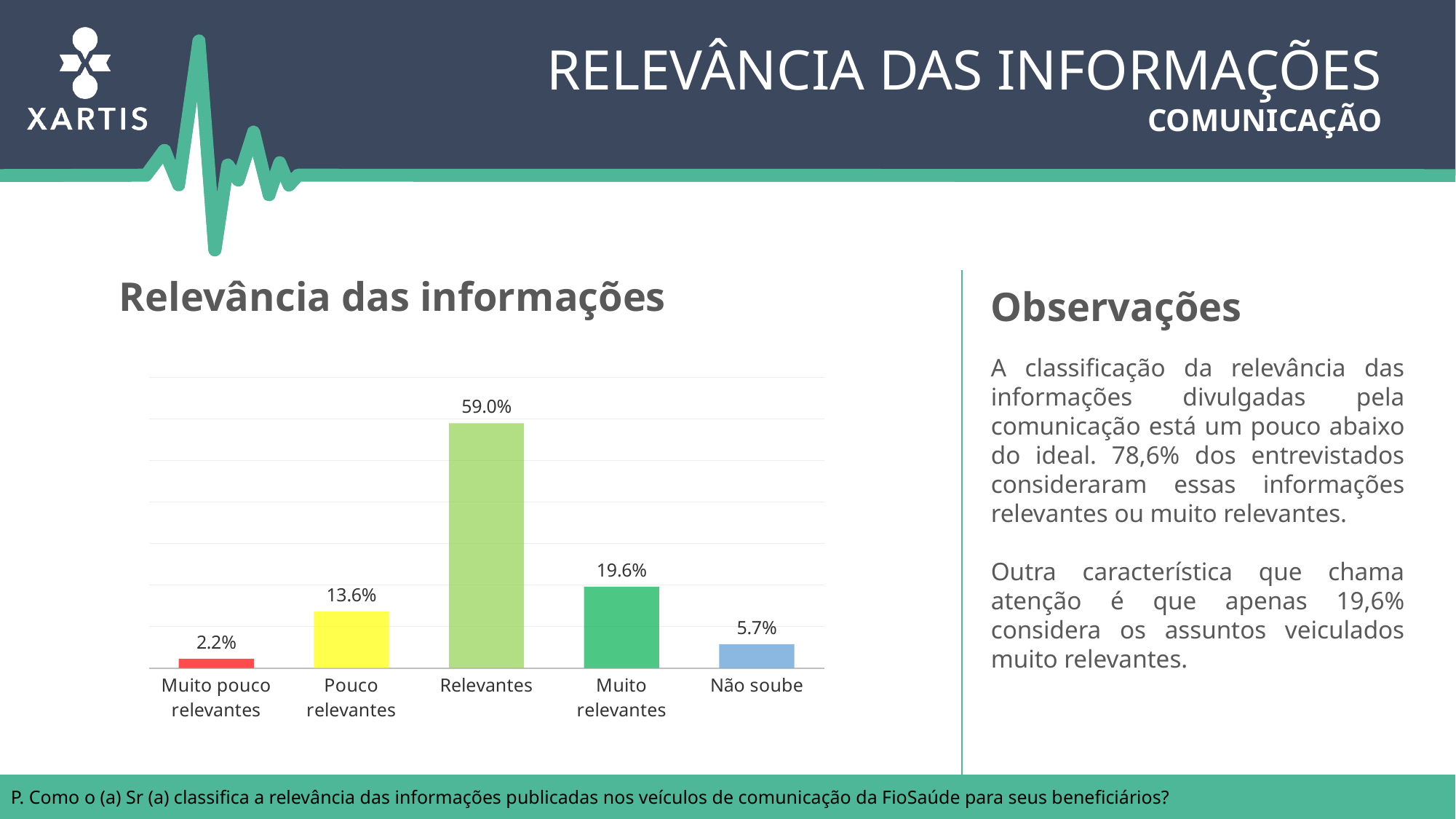
What is the value for Não soube? 5.7% What colour is the bar for Muito pouco relevantes? Red Which category has the lowest value? Muito pouco relevantes What is the value for Relevantes? 59.0% How many categories are shown on the x axis? 5 What is the value for Pouco relevantes? 13.6% Which category has the highest value? Relevantes Which is larger, the value for Pouco relevantes or the value for Não soube? Pouco relevantes What kind of chart is shown on the slide? Bar chart What is the difference between the values for Relevantes and Muito relevantes? 39.4% What is the title of the chart? Relevância das informações What is the value for Muito pouco relevantes? 2.2%